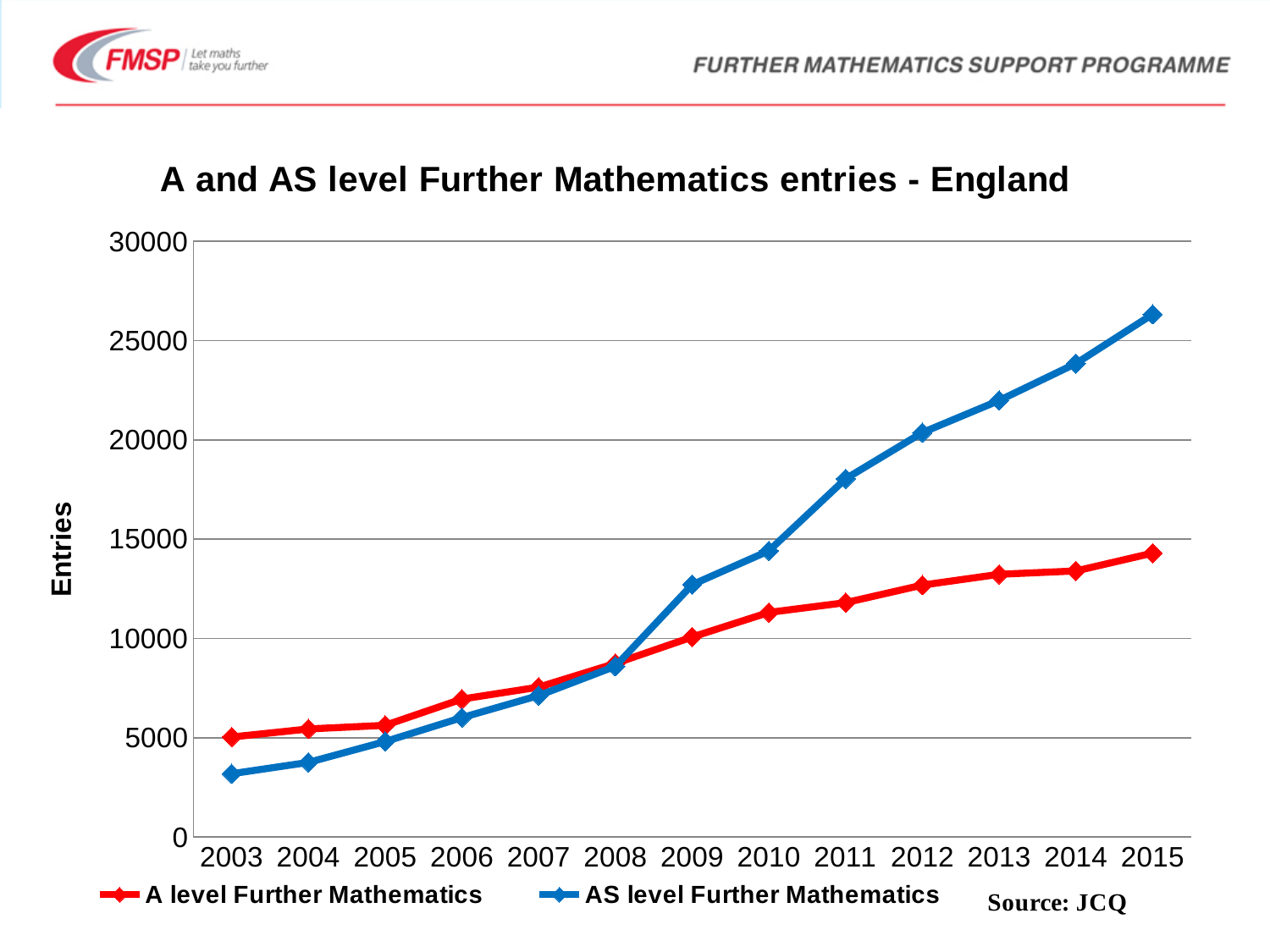
In which year are the AS level Further Mathematics entries highest? 2015 Is the value for AS level Further Mathematics in 2015 greater or less than 25000? greater What is the label on the vertical axis? Entries Is the value for A level Further Mathematics in 2015 greater or less than 15000? less In which year are the A level Further Mathematics entries lowest? 2003 Is the value for AS level Further Mathematics in 2003 greater or less than 5000? less How many series does the legend list? 2 How many years are plotted along the x axis? 13 What kind of chart is shown on the slide? line chart Do the AS level Further Mathematics entries rise or fall from 2003 to 2015? rise What is the title of the chart? A and AS level Further Mathematics entries - England In 2015, which series has more entries, A level Further Mathematics or AS level Further Mathematics? AS level Further Mathematics